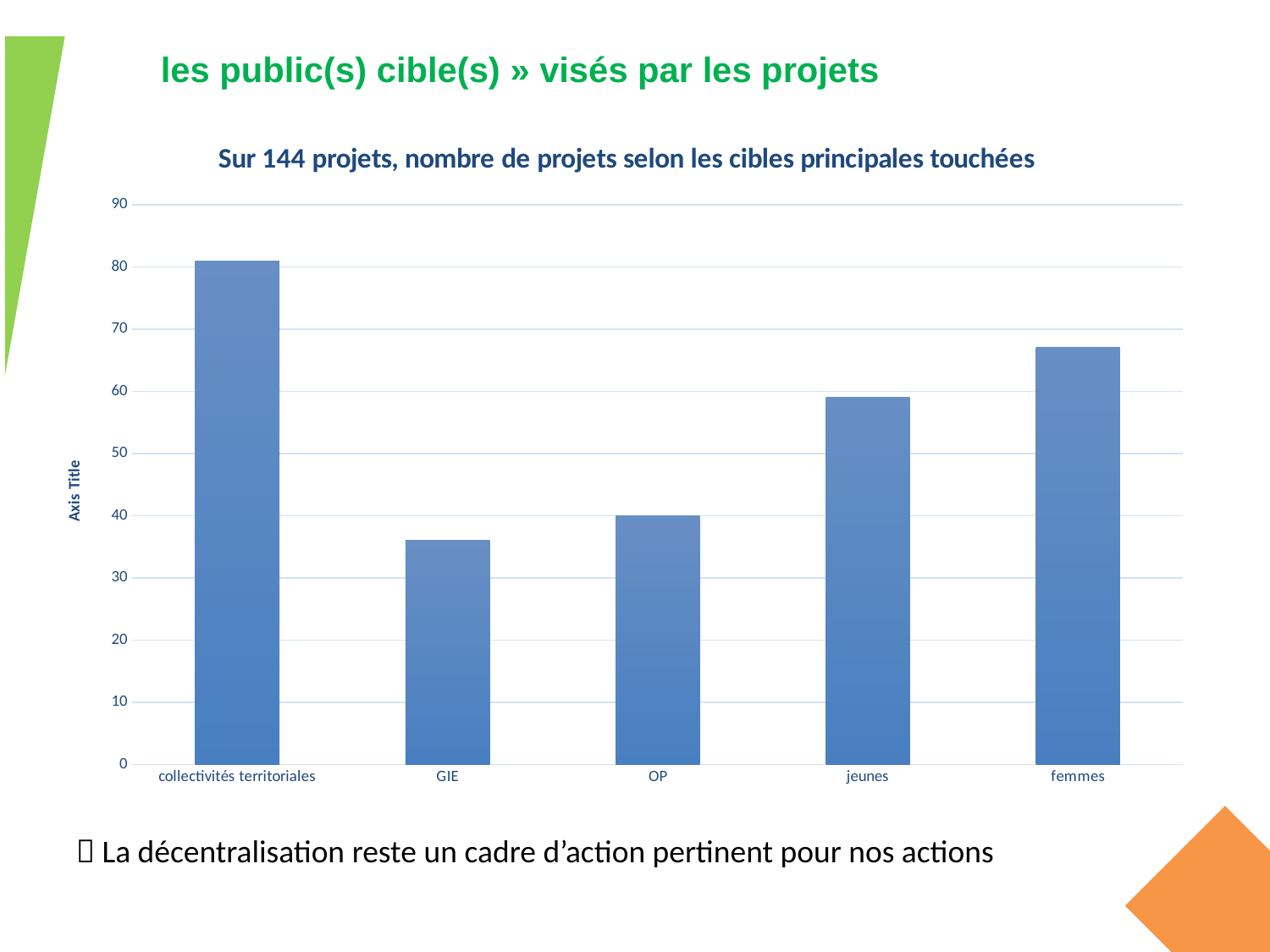
Which category has the highest number of projects? collectivités territoriales How many categories are shown on the x axis of the chart? 5 Is the value for femmes greater or less than 60? greater Is the value for collectivités territoriales greater or less than 70? greater Is the value for GIE greater or less than 40? less Which category has the lowest number of projects? GIE Which has a higher value, OP or GIE? OP What kind of chart is shown on the slide? bar chart What is the title of the chart? Sur 144 projets, nombre de projets selon les cibles principales touchées Which has a higher value, femmes or jeunes? femmes